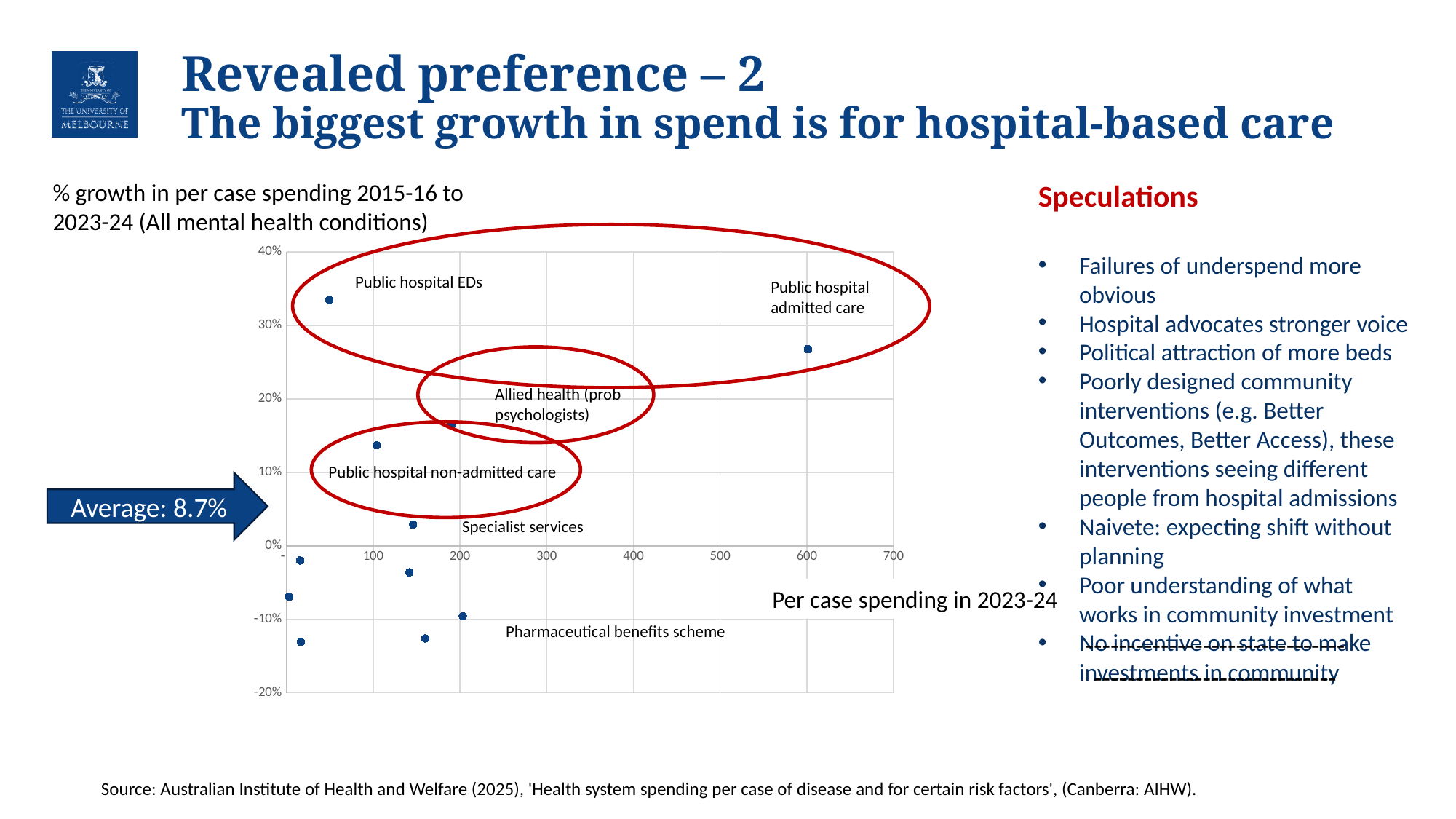
What average % growth is shown in the arrow next to the chart? 8.7% Which has the higher per case spending in 2023-24, Public hospital admitted care or Public hospital EDs? Public hospital admitted care What is the label of the horizontal axis of the chart? Per case spending in 2023-24 Is the % growth for Pharmaceutical benefits scheme greater or less than 0%? less Which labelled service has the lowest % growth in per case spending? Pharmaceutical benefits scheme What kind of chart is shown on the slide? scatter chart Is the % growth for Public hospital EDs greater or less than 30%? greater Is the % growth for Public hospital admitted care greater or less than 30%? less Which labelled service has the highest % growth in per case spending? Public hospital EDs Which has the higher % growth in per case spending, Public hospital EDs or Public hospital admitted care? Public hospital EDs